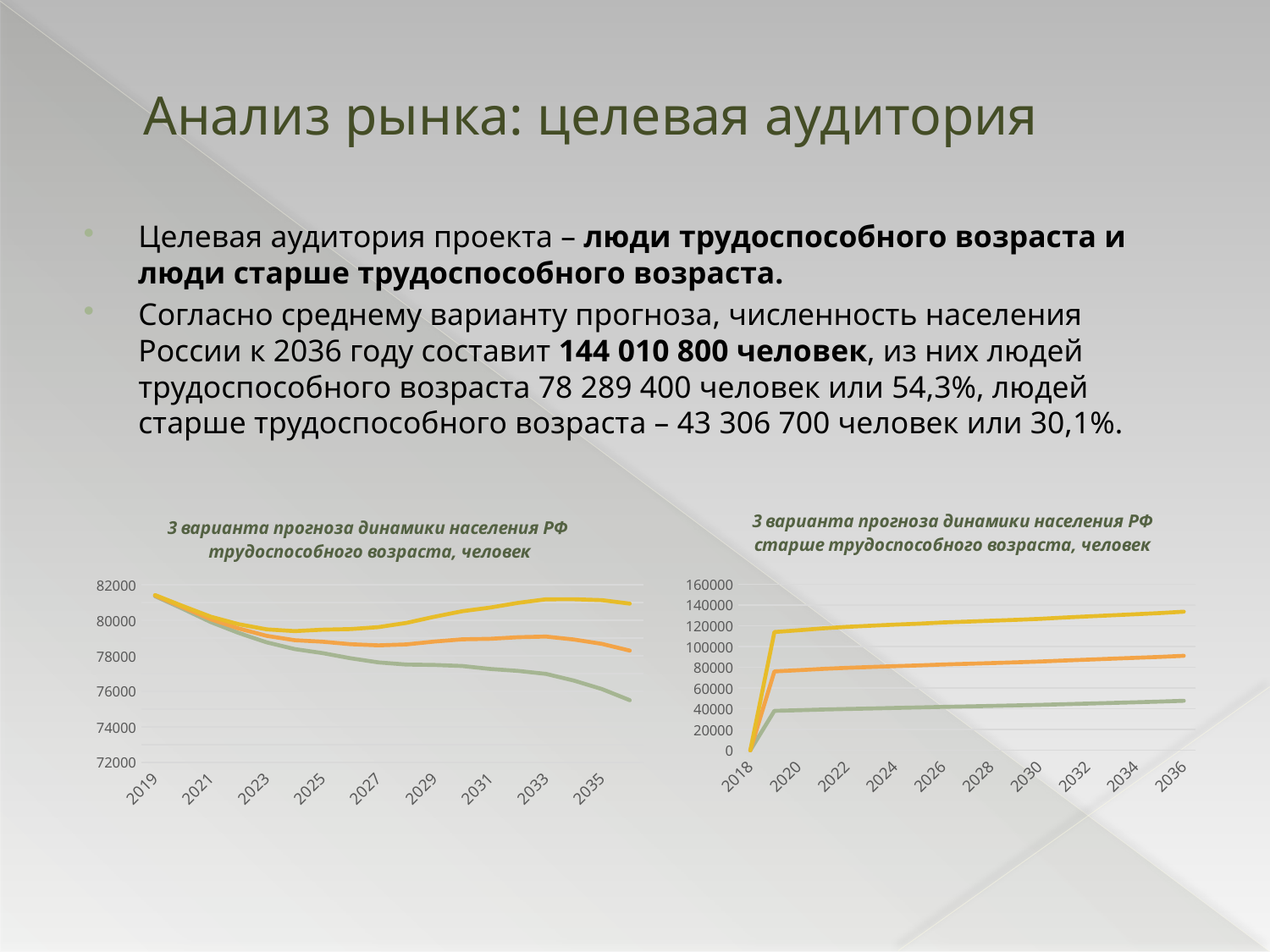
In the left chart (трудоспособного возраста), is the value of the yellow line in 2035 greater or less than 80000? greater What is the highest value shown on the y axis of the right chart (старше трудоспособного возраста)? 160000 What kind of chart is the left chart, '3 варианта прогноза динамики населения РФ трудоспособного возраста, человек'? line chart In the right chart (старше трудоспособного возраста), how many year labels are shown on the x axis? 10 What kind of chart is the right chart, '3 варианта прогноза динамики населения РФ старше трудоспособного возраста, человек'? line chart In the right chart (старше трудоспособного возраста), does the yellow line rise or fall from 2020 to 2036? rise In the right chart (старше трудоспособного возраста), is the value of the green line in 2036 greater or less than 60000? less In the left chart (трудоспособного возраста), does the green line rise or fall from 2019 to 2035? fall In the right chart (старше трудоспособного возраста), is the value of the yellow line in 2036 greater or less than 120000? greater In the left chart (трудоспособного возраста), how many lines are plotted? 3 In the left chart (трудоспособного возраста), which line is highest in 2035: yellow, orange or green? yellow